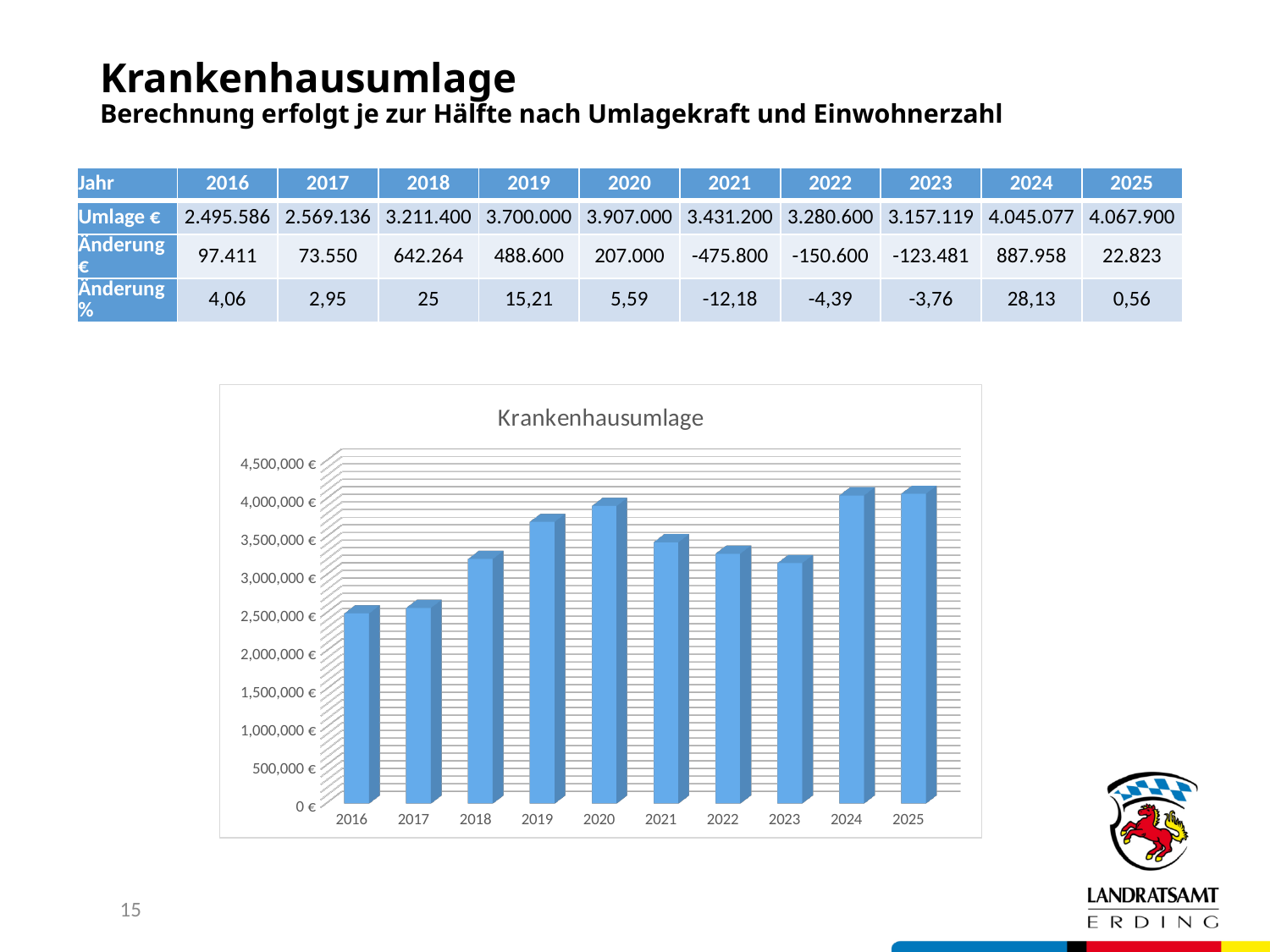
How many years are plotted in the Krankenhausumlage chart? 10 Is the value for 2016 greater or less than 3,000,000 €? less What kind of chart is shown on the slide? bar chart According to the table on the slide, what is the Umlage in € for 2020? 3.907.000 Is the value for 2022 greater or less than 3,000,000 €? greater Which is larger, the Krankenhausumlage for 2018 or for 2021? 2021 Is the value for 2024 greater or less than 4,000,000 €? greater Which year has the lowest Krankenhausumlage in the chart? 2016 What is the title of the chart? Krankenhausumlage Do the values rise or fall from 2016 to 2020? rise Do the values rise or fall from 2020 to 2023? fall